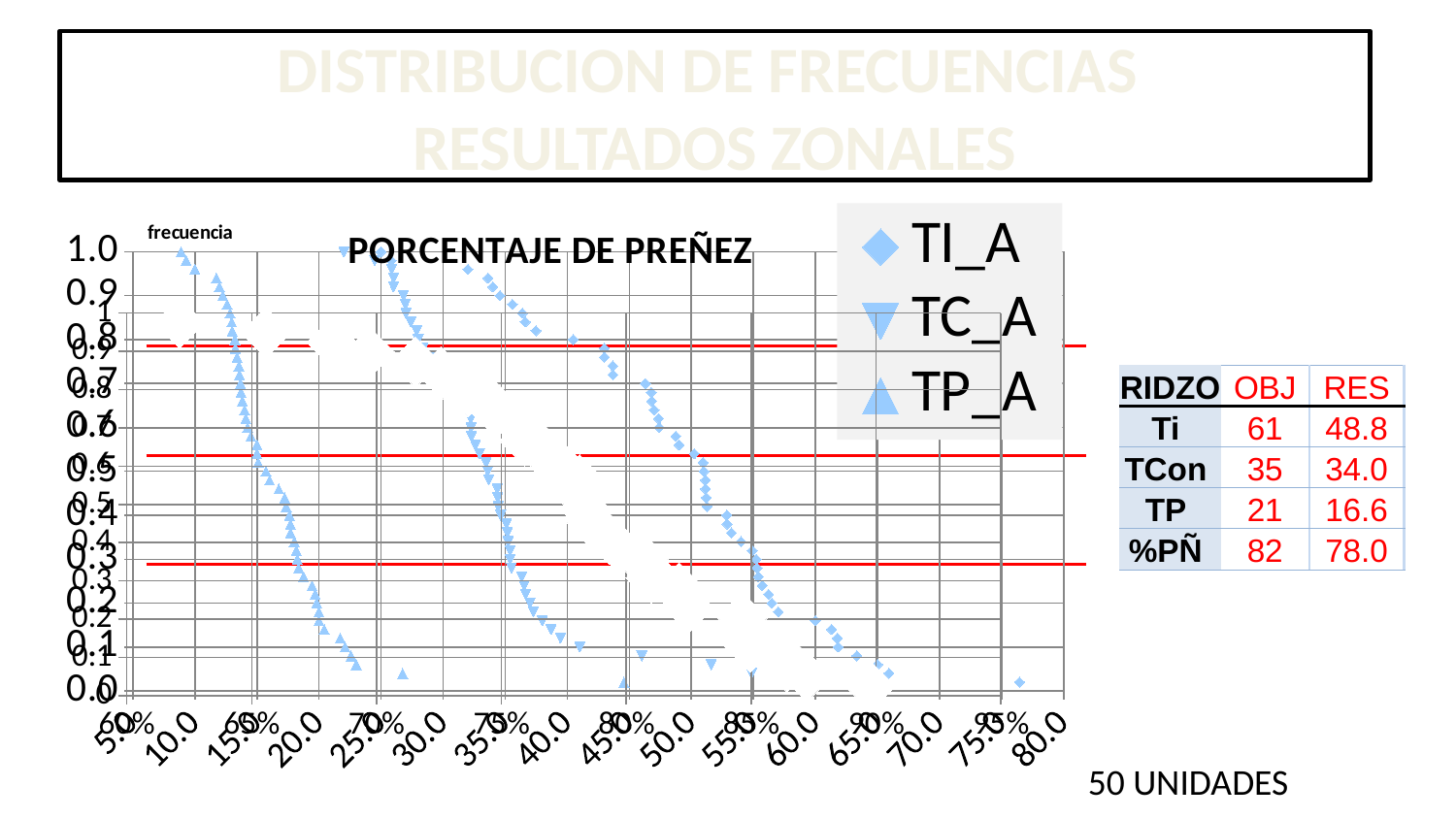
What kind of chart is shown on the slide? scatter chart What are the three series named in the chart legend? TI_A, TC_A, TP_A How many series does the chart legend list? 3 What is the title of the chart? PORCENTAJE DE PREÑEZ What is the highest value shown on the chart's y axis? 1.0 Do the plotted values of the series rise or fall as you move from left to right along the x axis? fall